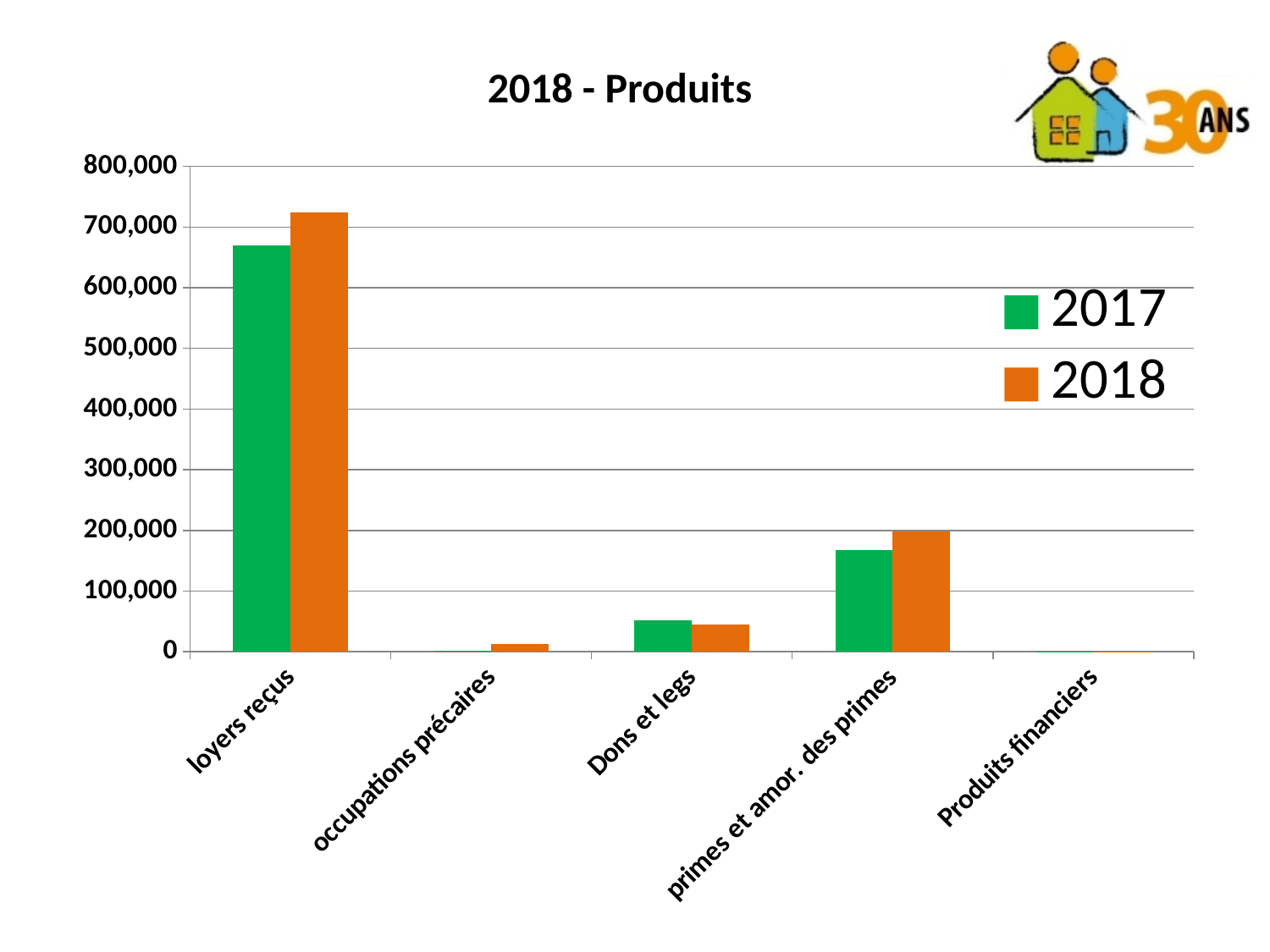
Is the 2017 value for loyers reçus greater or less than 700,000? less Which category has the highest value for 2017? loyers reçus Is the 2018 value for primes et amor. des primes greater or less than 100,000? greater Which category has the highest value for 2018? loyers reçus What is the title of the chart? 2018 - Produits Is the 2017 value for Dons et legs greater or less than 100,000? less For primes et amor. des primes, which year has the larger value, 2017 or 2018? 2018 How many categories are shown on the x axis? 5 How many series does the legend list? 2 What kind of chart is shown on the slide? bar chart For loyers reçus, which year has the larger value, 2017 or 2018? 2018